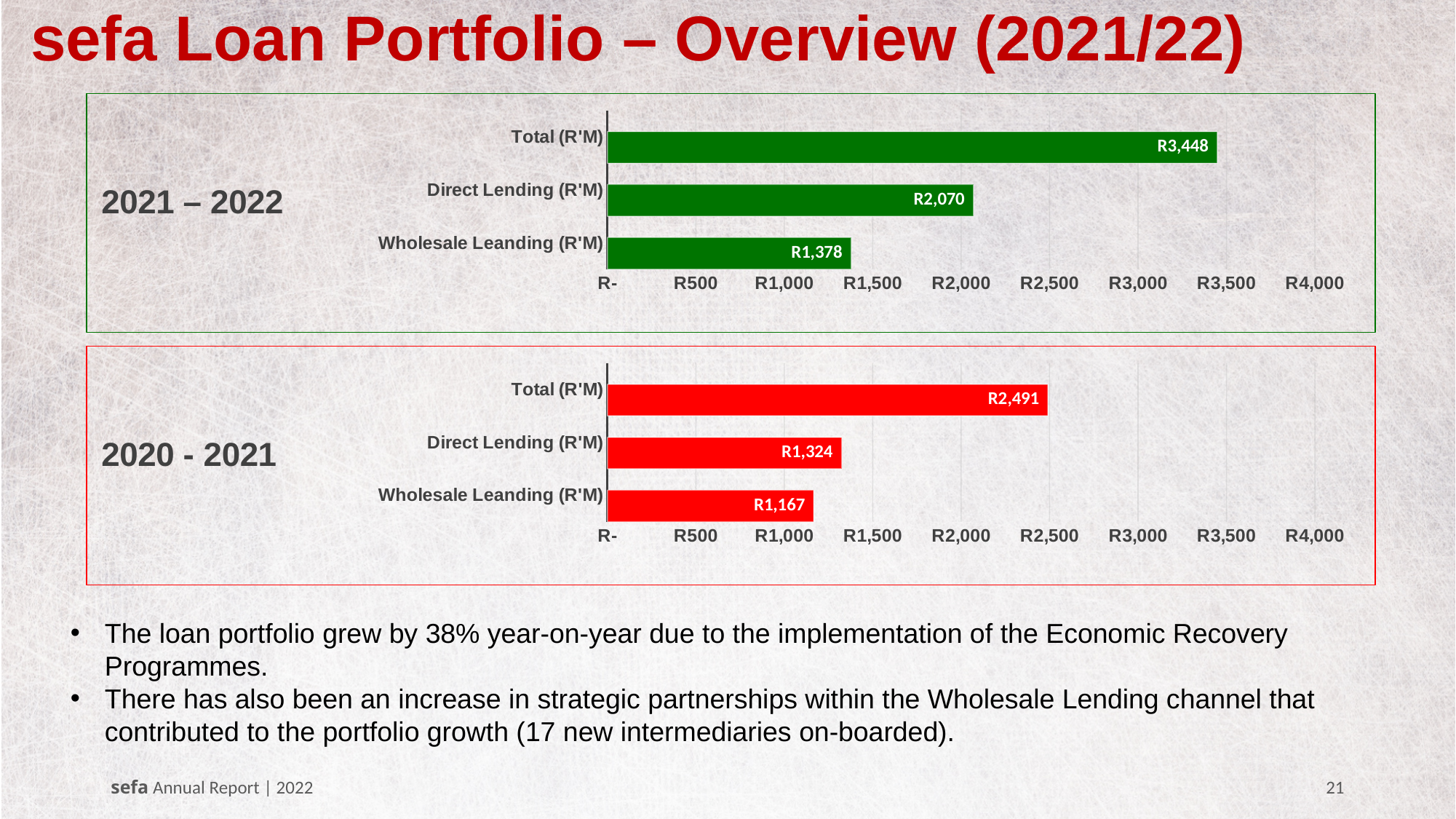
In the 2020 - 2021 chart, is the value for Total (R'M) greater or less than R3,000? less In the 2020 - 2021 chart, what is the value for Wholesale Leanding (R'M)? R1,167 In the 2021 – 2022 chart, what is the value for Direct Lending (R'M)? R2,070 In the 2021 – 2022 chart, what is the value for Total (R'M)? R3,448 Which is larger: Direct Lending (R'M) in the 2021 – 2022 chart or Direct Lending (R'M) in the 2020 - 2021 chart? 2021 – 2022 What kind of chart is the 2020 - 2021 chart? bar chart In the 2020 - 2021 chart, which category has the highest value? Total (R'M) What is the difference between the Total (R'M) in the 2021 – 2022 chart and the Total (R'M) in the 2020 - 2021 chart? R957 How many categories are shown in the 2021 – 2022 chart? 3 In the 2020 - 2021 chart, what is the value for Direct Lending (R'M)? R1,324 In the 2021 – 2022 chart, which category has the lowest value? Wholesale Leanding (R'M) In the 2021 – 2022 chart, what is the difference between Direct Lending (R'M) and Wholesale Leanding (R'M)? R692